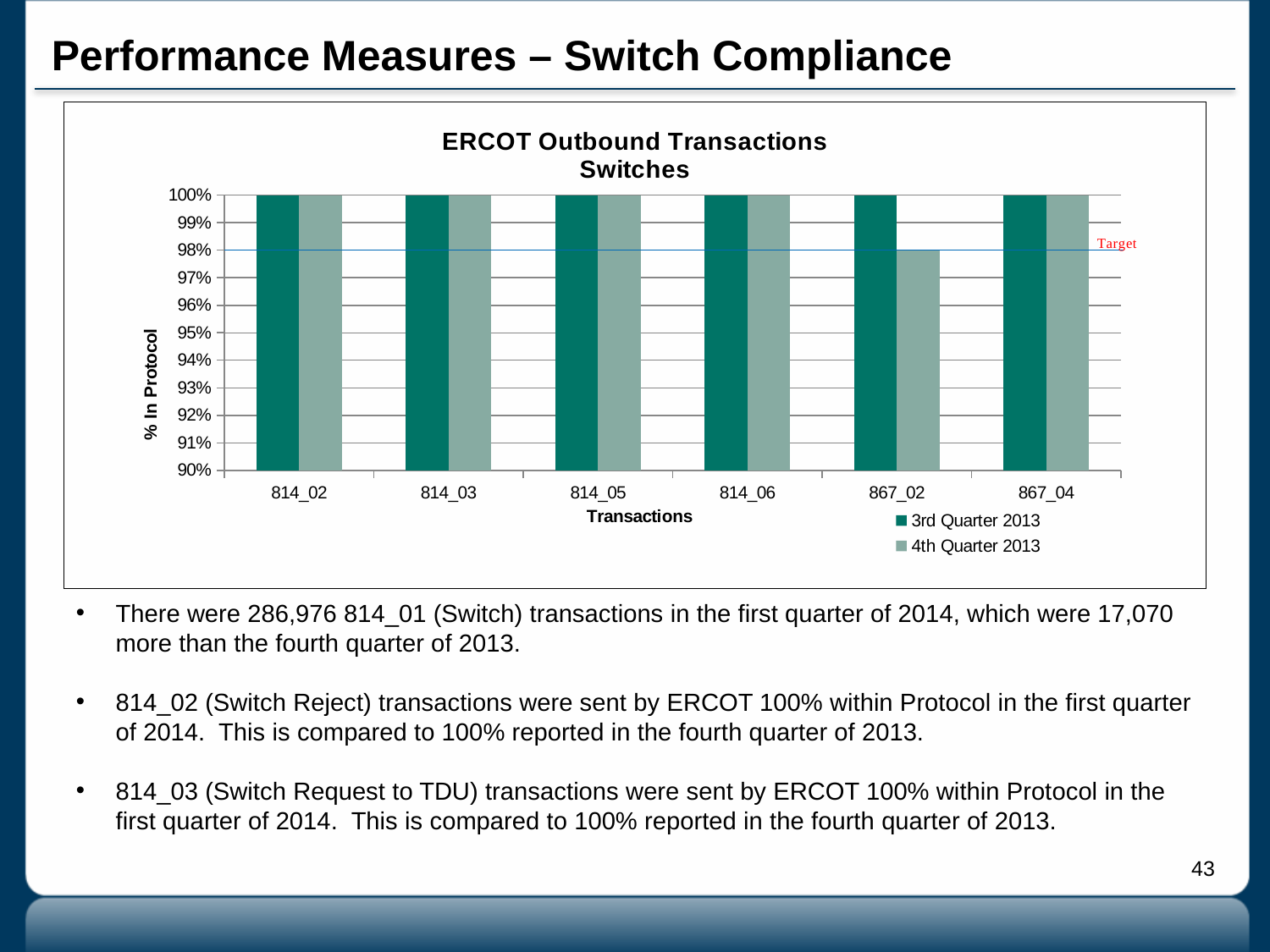
What is the difference between the 3rd Quarter 2013 and 4th Quarter 2013 values for 867_02? 2% Which is larger for 867_02: the 3rd Quarter 2013 value or the 4th Quarter 2013 value? 3rd Quarter 2013 What is the 4th Quarter 2013 value for 867_02? 98% What is the label on the y axis of the chart? % In Protocol Is the 4th Quarter 2013 value for 867_02 greater or less than 99%? less What is the title of the chart? ERCOT Outbound Transactions Switches What is the 3rd Quarter 2013 value for 814_05? 100% How many transaction categories are shown on the x axis of the chart? 6 What is the 4th Quarter 2013 value for 814_03? 100% How many series does the chart's legend list? 2 What kind of chart is shown on the slide? bar chart Which transaction category has the lowest 4th Quarter 2013 value? 867_02